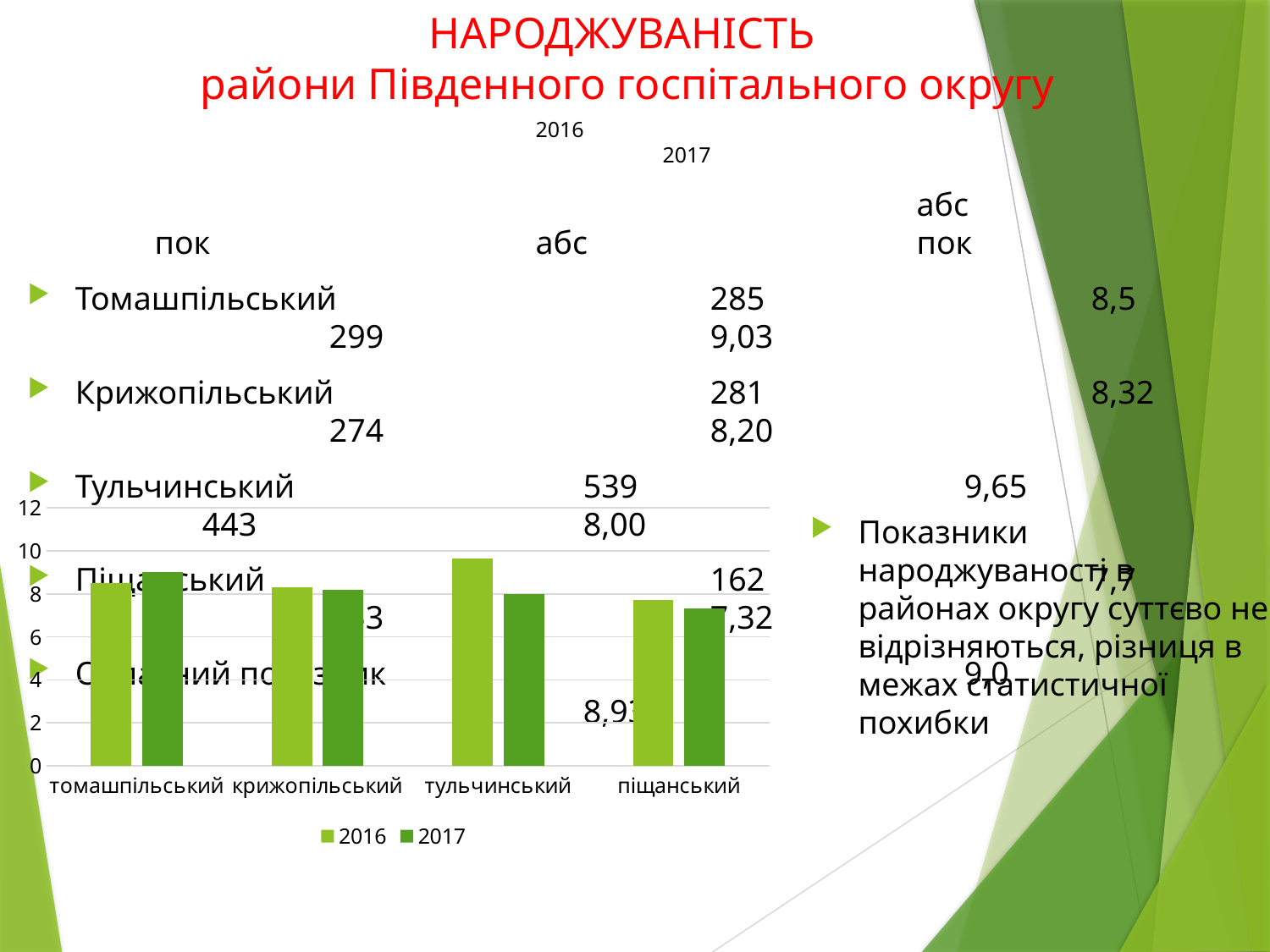
Which district has the highest bar for 2016? тульчинський What are the two series named in the chart legend? 2016 and 2017 What kind of chart is shown on the slide? bar chart How many districts (categories) are shown on the x axis of the chart? 4 Do the 2017 values rise or fall moving from томашпільський to піщанський along the x axis? fall Which district has the lowest bar for 2016? піщанський How many series does the chart legend list? 2 Which district has the lowest bar for 2017? піщанський Which district has the highest bar for 2017? томашпільський Is the 2017 value for піщанський greater or less than 8? less Is the 2016 value for тульчинський greater or less than 8? greater For тульчинський, which year has the larger value, 2016 or 2017? 2016